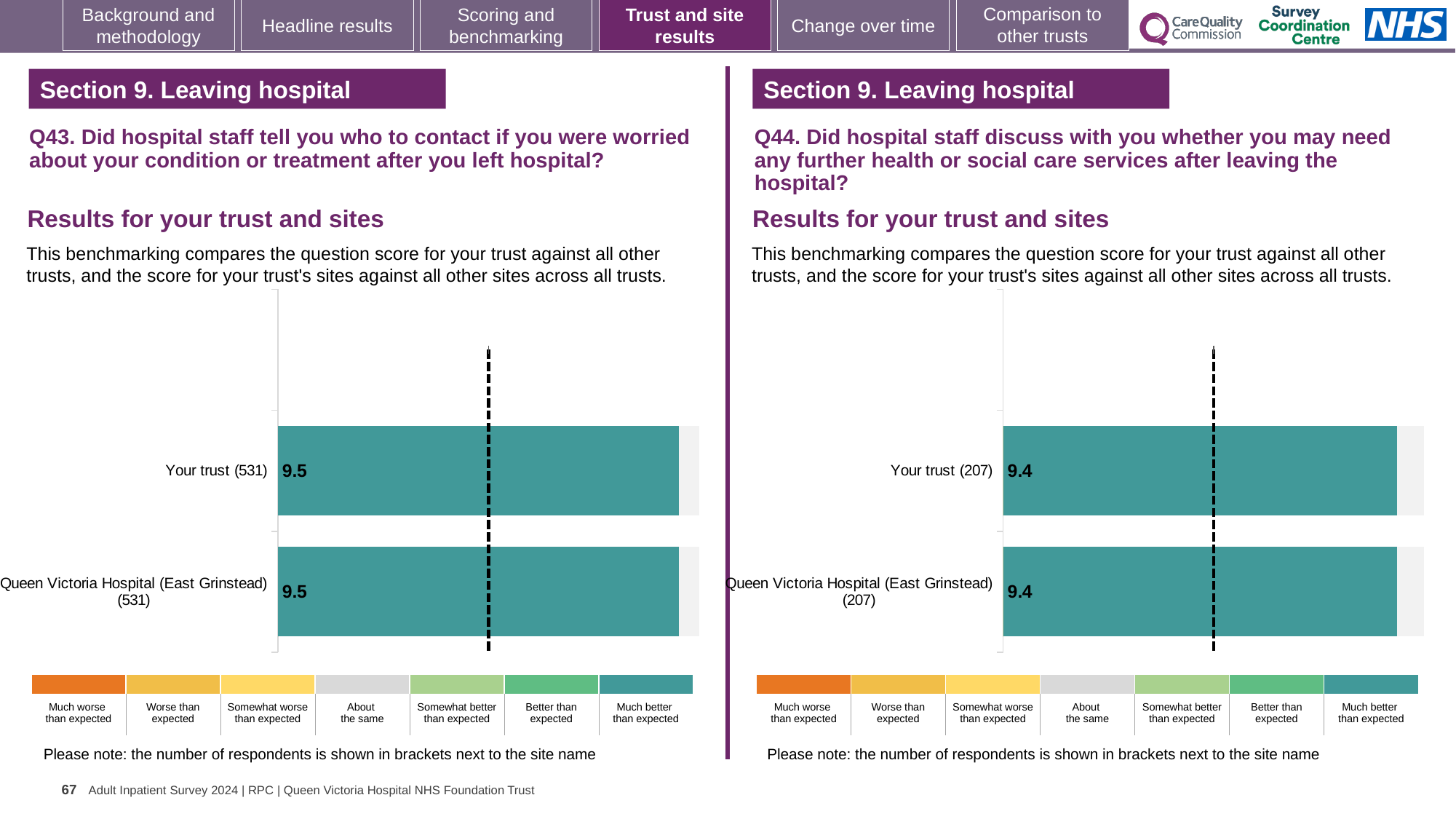
On the Q43 chart (left), what is the score for Your trust? 9.5 How many bars are plotted on the Q43 chart (left)? 2 On the Q43 chart (left), what is the score for Queen Victoria Hospital (East Grinstead)? 9.5 On the Q44 chart (right), what is the score for Your trust? 9.4 On the Q44 chart (right), what is the score for Queen Victoria Hospital (East Grinstead)? 9.4 On the Q44 chart (right), how many respondents are shown in brackets next to Queen Victoria Hospital (East Grinstead)? 207 What type of chart is used for the Q43 results on the left? Bar chart On the Q43 chart (left), what is the difference between the score for Your trust and the score for Queen Victoria Hospital (East Grinstead)? 0 How many bars are plotted on the Q44 chart (right)? 2 Is the score for Your trust on the Q44 chart (right) larger or smaller than the score for Your trust on the Q43 chart (left)? Smaller On the Q43 chart (left), how many respondents are shown in brackets next to Your trust? 531 On the Q44 chart (right), what is the difference between the score for Your trust and the score for Queen Victoria Hospital (East Grinstead)? 0